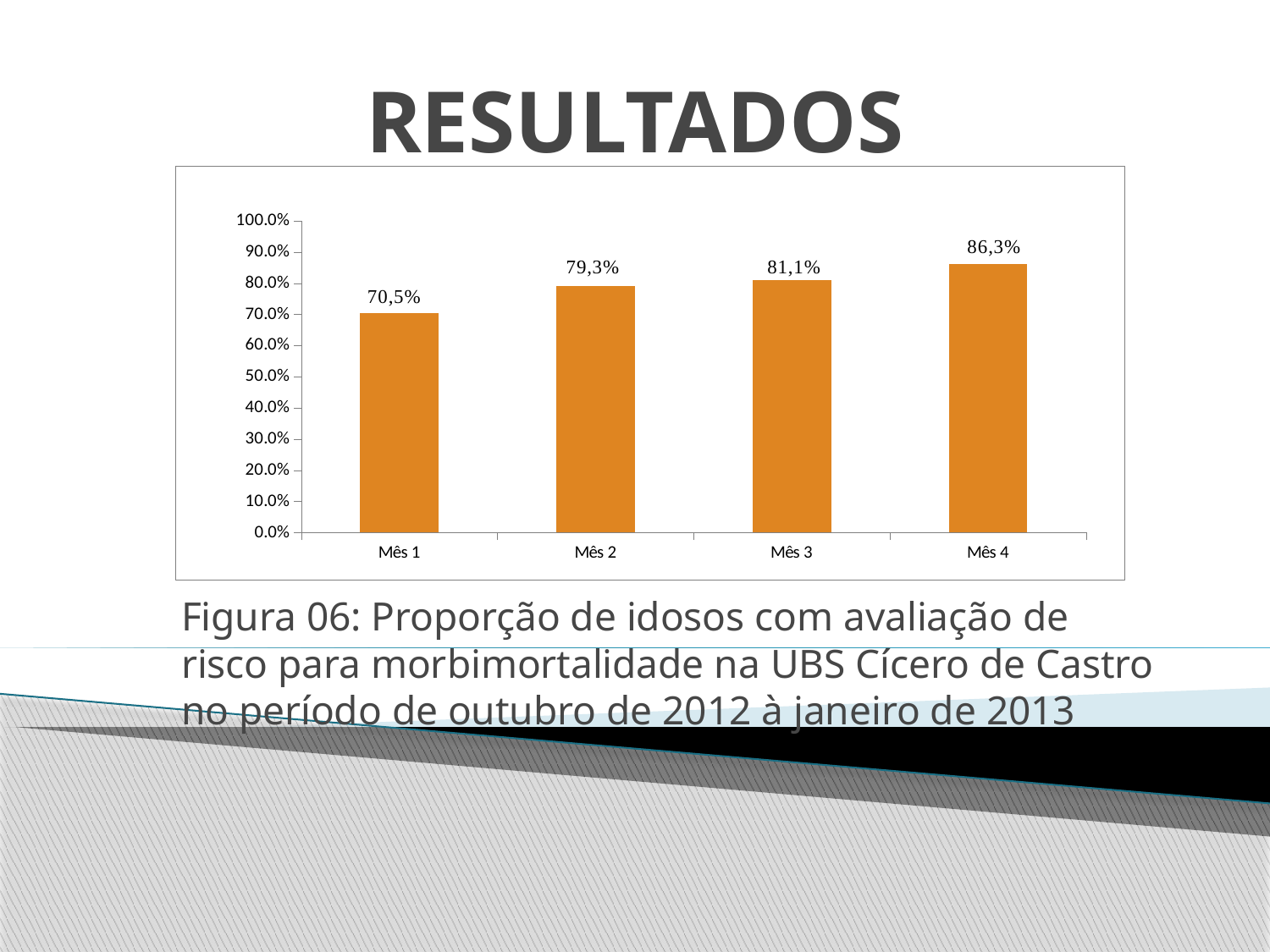
Which month has the lowest value? Mês 1 How many months are shown on the x axis? 4 What is the difference between the values for Mês 2 and Mês 1? 8,8% What kind of chart is shown on the slide? bar chart Which month has the highest value? Mês 4 What is the value for Mês 3? 81,1% What is the value for Mês 1? 70,5% What is the difference between the values for Mês 4 and Mês 1? 15,8% Do the values rise or fall from Mês 1 to Mês 4? rise What is the value for Mês 4? 86,3% Which is larger, the value for Mês 2 or the value for Mês 3? Mês 3 Is the value for Mês 2 greater or less than 70.0%? greater